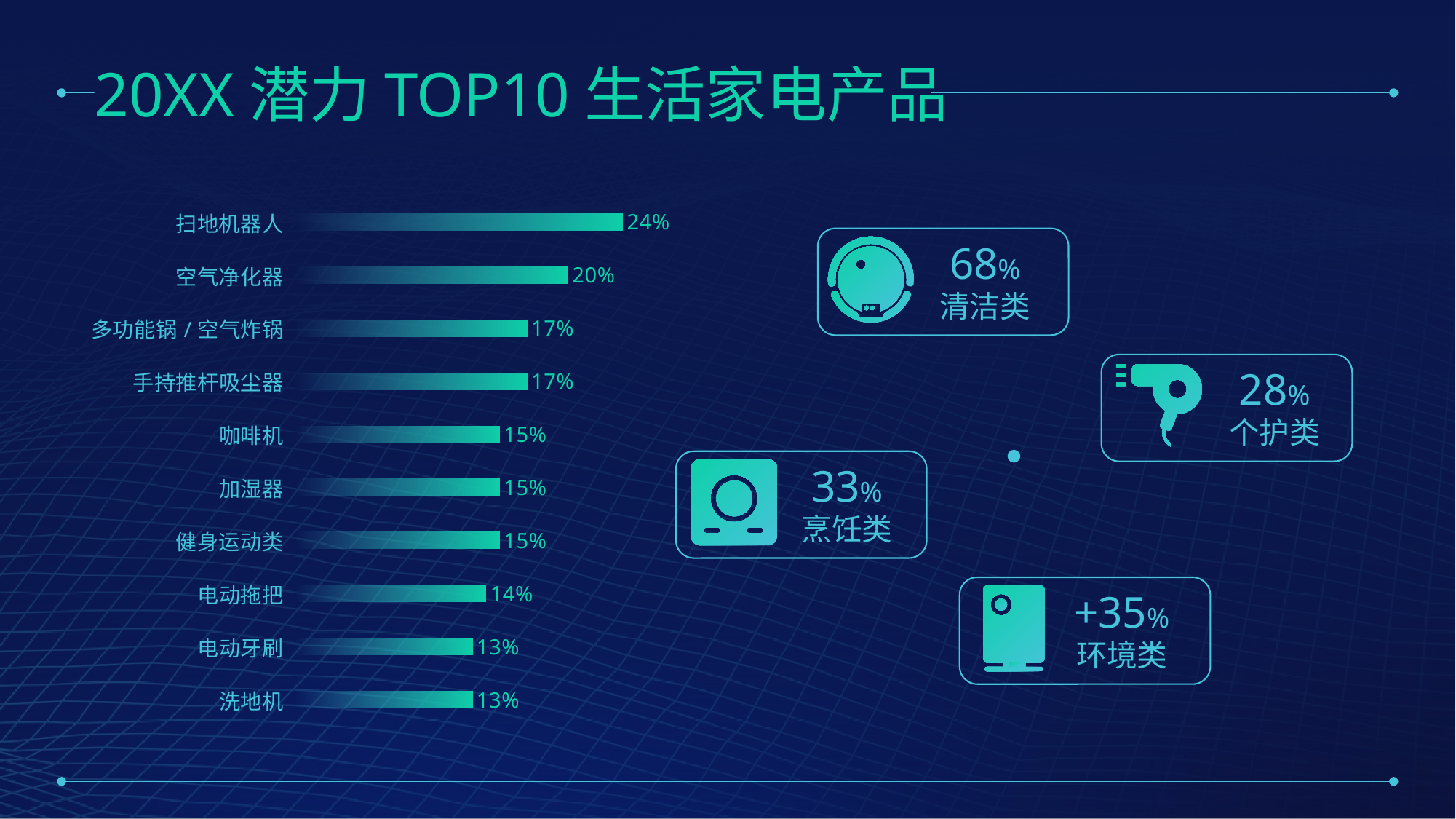
What is the value for 空气净化器? 20% What is the title of the slide containing the bar chart? 20XX 潜力 TOP10 生活家电产品 What is the lowest value shown in the bar chart? 13% What is the value for 扫地机器人? 24% Which category has the highest value in the bar chart? 扫地机器人 Which is larger, the value for 手持推杆吸尘器 or the value for 电动牙刷? 手持推杆吸尘器 What is the value for 咖啡机? 15% How many product categories are shown in the bar chart? 10 What type of chart is shown on the slide? bar chart What is the difference between the values for 扫地机器人 and 空气净化器? 4% Do the bar values increase or decrease going from the top category to the bottom category? decrease What is the value for 电动拖把? 14%